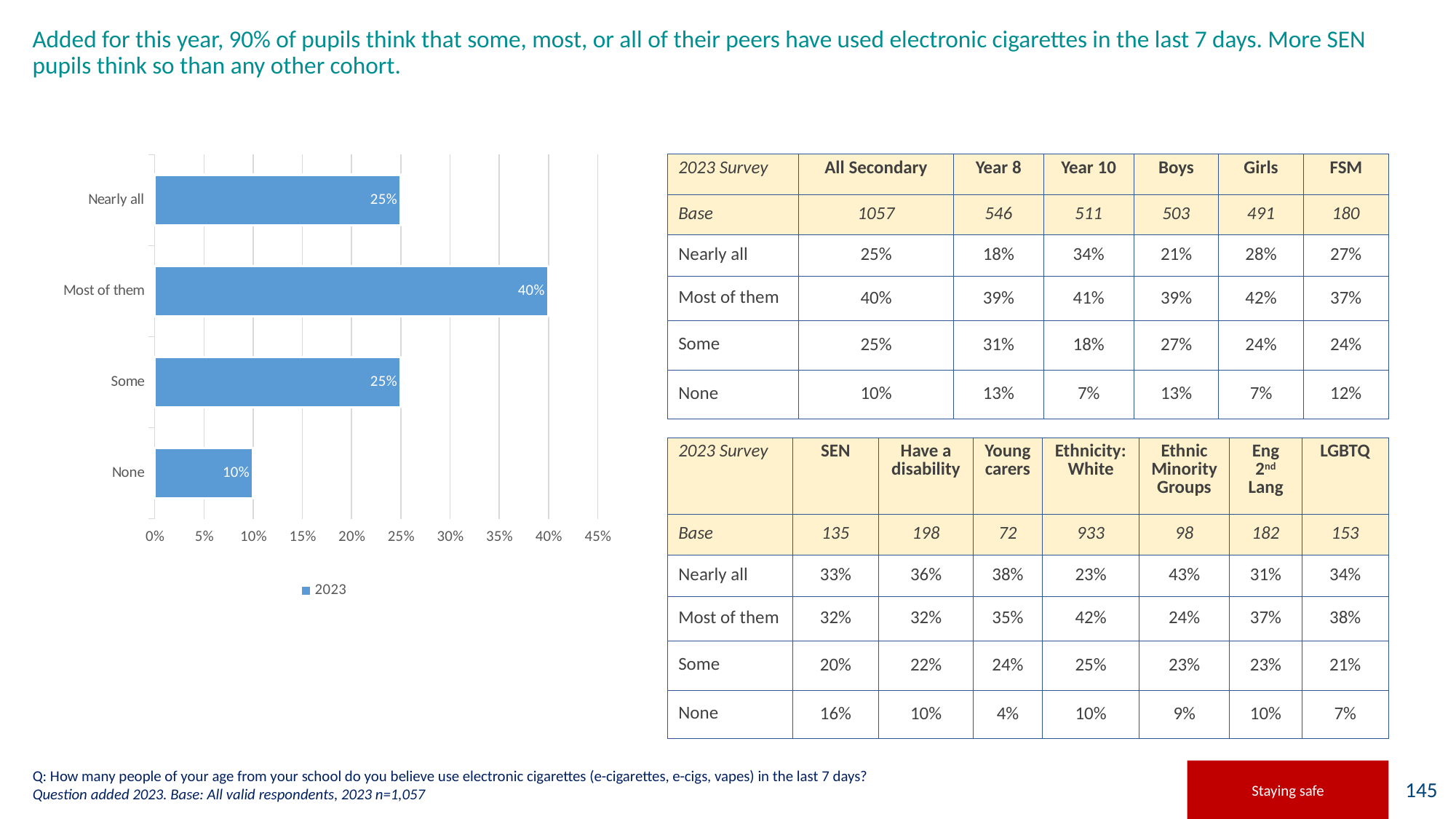
What type of chart is shown on the slide? Bar chart What is the value for "Nearly all" in the bar chart? 25% How many categories are shown in the bar chart? 4 Which category has the lowest value in the bar chart? None What is the value for "Most of them" in the bar chart? 40% Which category has the highest value in the bar chart? Most of them How many series does the legend of the bar chart list? 1 Which is larger in the bar chart, the value for "Some" or the value for "None"? Some What is the value for "None" in the bar chart? 10% What is the difference between the values for "Most of them" and "None" in the bar chart? 30% What is the legend entry shown below the bar chart? 2023 What is the difference between the values for "Most of them" and "Some" in the bar chart? 15%